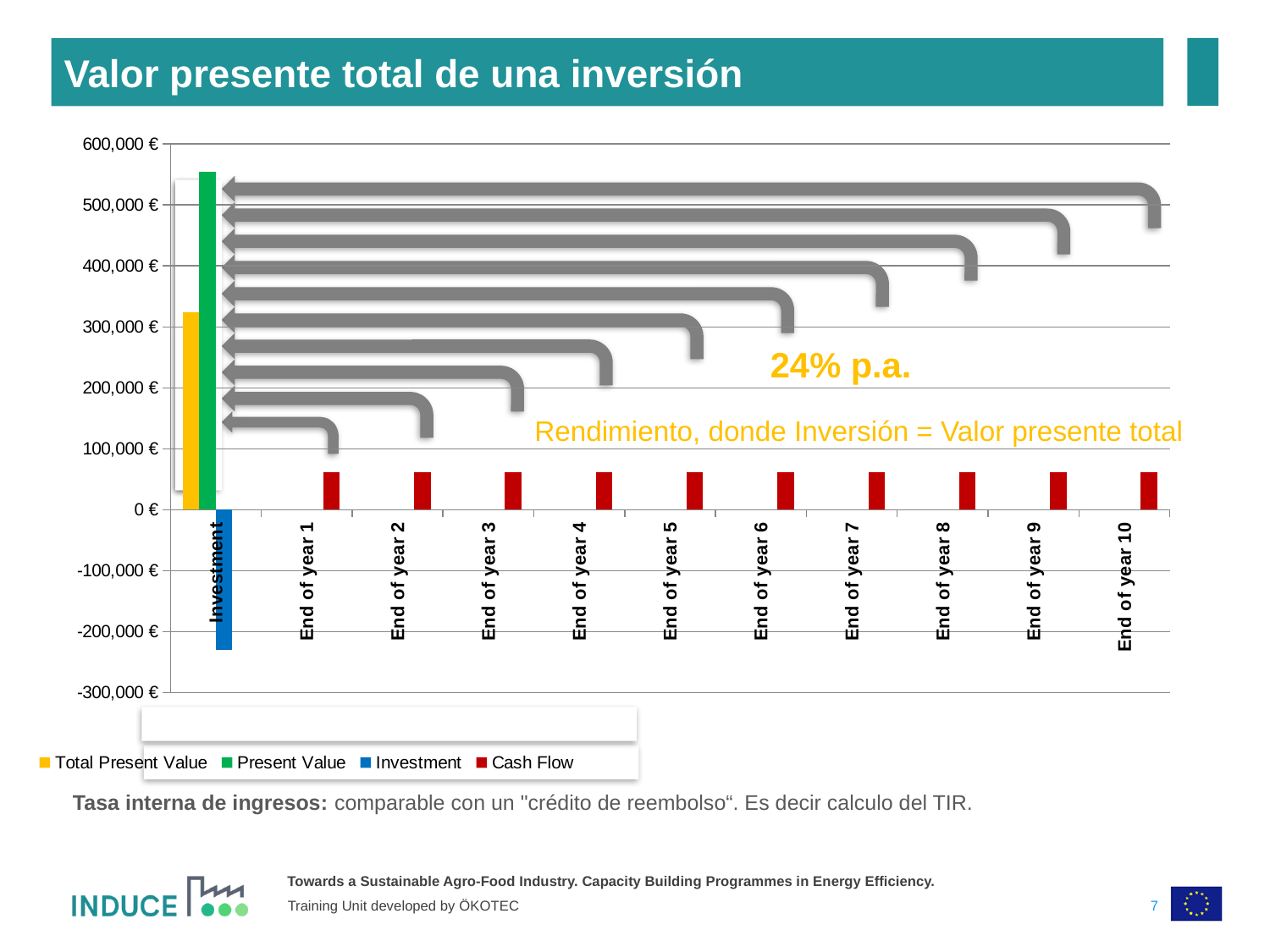
Is the Present Value bar for Investment greater or less than 500,000 €? greater What kind of chart is shown on the slide? bar chart How many categories are shown along the x axis of the chart? 11 What colour represents the Cash Flow series in the chart legend? red How many series does the chart legend list? 4 Is the Total Present Value bar for Investment greater or less than 300,000 €? greater Is the Total Present Value bar for Investment greater or less than 400,000 €? less Which series is the only one with a negative value in the chart? Investment Which is larger for the Investment category: the Present Value bar or the Total Present Value bar? Present Value What is the title of the slide containing the chart? Valor presente total de una inversión